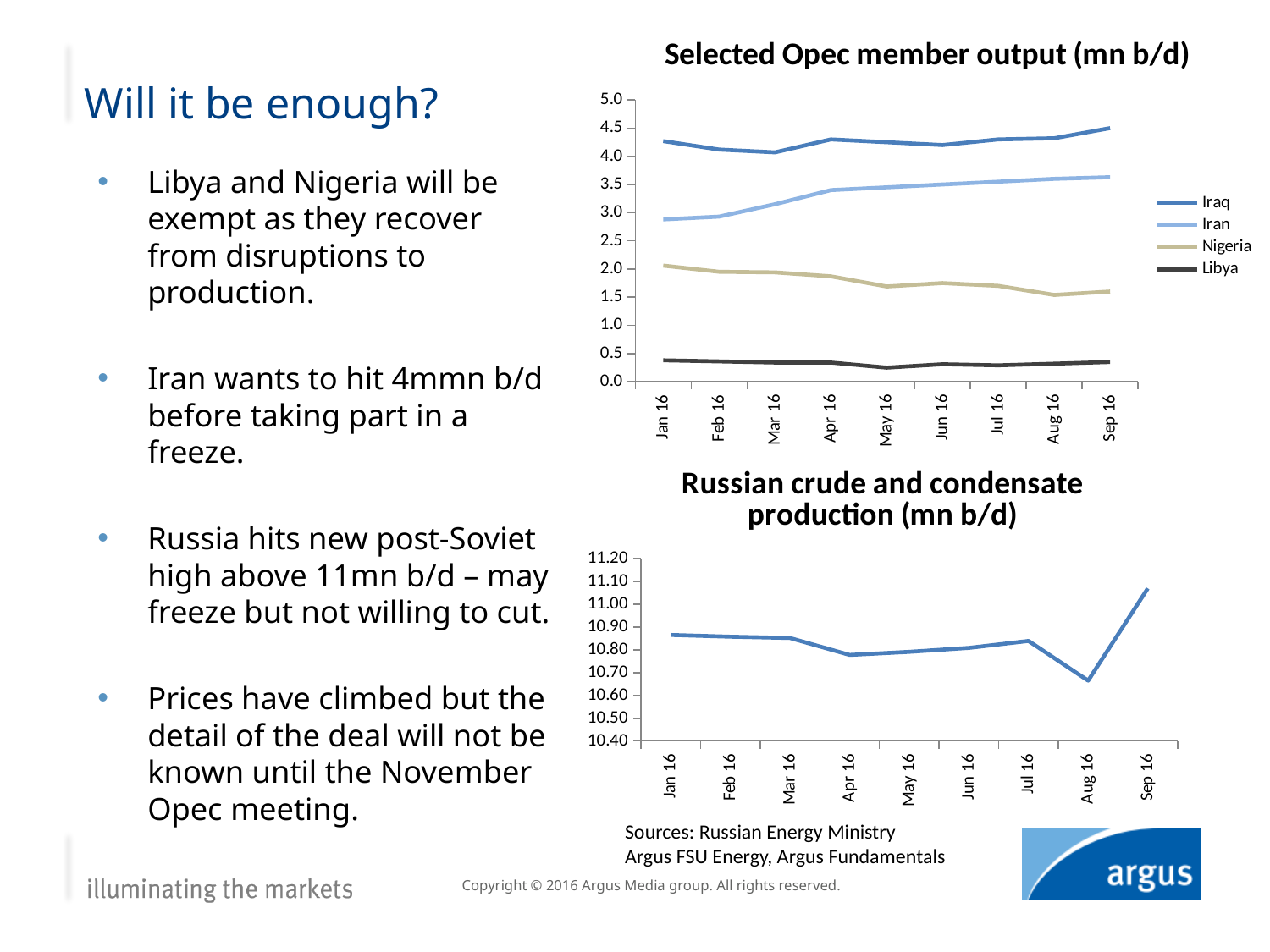
In the 'Selected Opec member output (mn b/d)' chart, which member has the lowest output throughout the period? Libya In the 'Selected Opec member output (mn b/d)' chart, which member has the highest output throughout the period? Iraq In the 'Selected Opec member output (mn b/d)' chart, is Iraq's output in Sep 16 greater or less than 4.0? greater In the 'Russian crude and condensate production (mn b/d)' chart, which month has the highest production? Sep 16 In the 'Selected Opec member output (mn b/d)' chart, is Libya's output in Jan 16 greater or less than 0.5? less What type of chart is the 'Selected Opec member output (mn b/d)' chart? line chart How many months are plotted on the x axis of the 'Russian crude and condensate production (mn b/d)' chart? 9 In the 'Selected Opec member output (mn b/d)' chart, does Nigeria's output rise or fall from Jan 16 to Sep 16? fall How many series does the legend of the 'Selected Opec member output (mn b/d)' chart list? 4 In the 'Russian crude and condensate production (mn b/d)' chart, is the value for Aug 16 greater or less than 10.70? less In the 'Selected Opec member output (mn b/d)' chart, does Iran's output rise or fall from Jan 16 to Sep 16? rise In the 'Selected Opec member output (mn b/d)' chart, which is larger in Sep 16: Iran's output or Nigeria's output? Iran